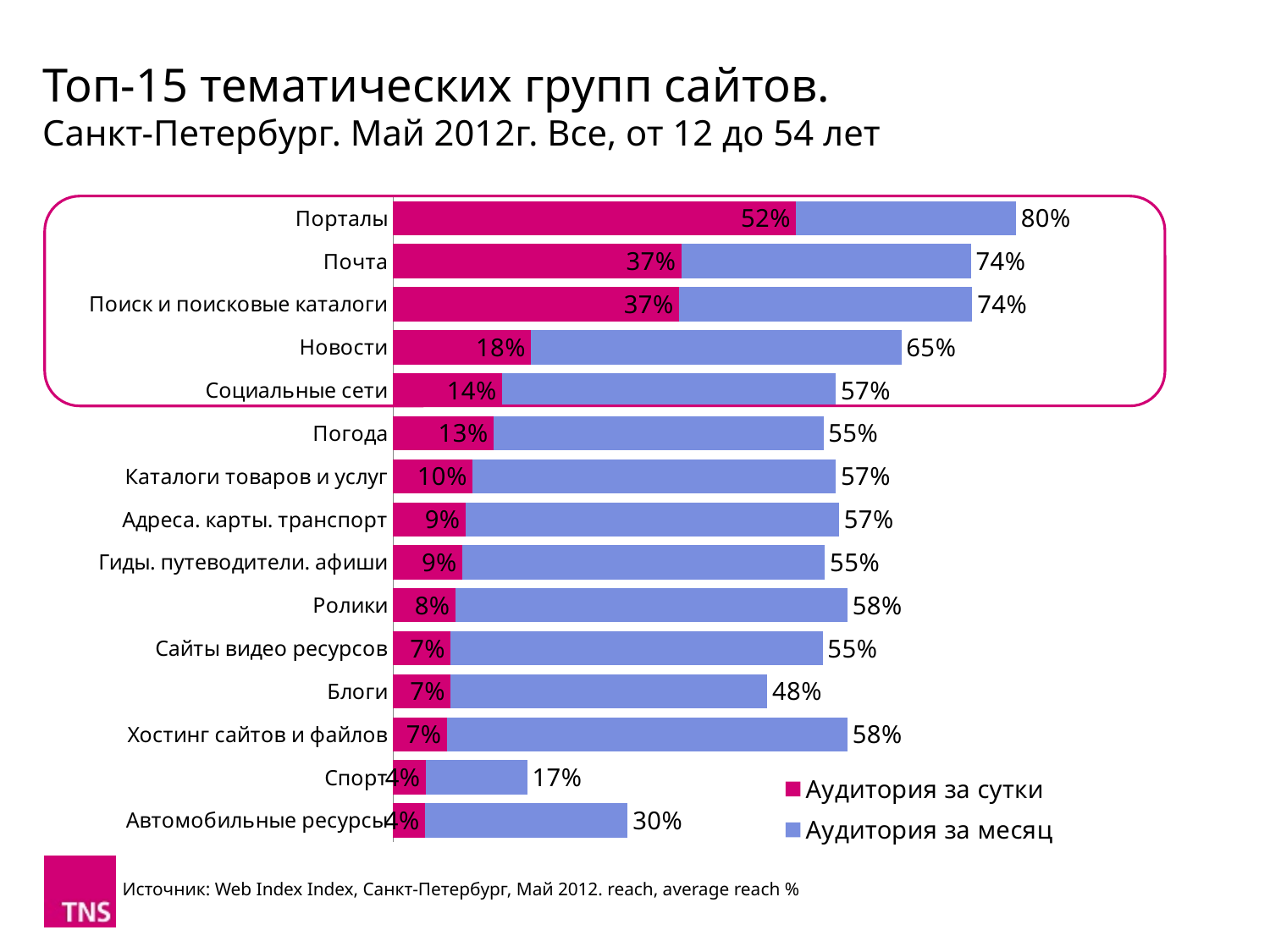
How many series does the legend list? 2 What is the monthly audience (Аудитория за месяц) value for Порталы? 80% What kind of chart is shown on the slide? bar chart How many thematic groups of sites are shown in the chart? 15 What is the difference between the monthly and daily audience values for Социальные сети? 43% Which category has the lowest monthly audience (Аудитория за месяц)? Спорт Which category has the highest monthly audience (Аудитория за месяц)? Порталы What is the daily audience (Аудитория за сутки) value for Новости? 18% Which series is shown in magenta in the legend? Аудитория за сутки What is the monthly audience (Аудитория за месяц) value for Блоги? 48% Which has a larger monthly audience (Аудитория за месяц): Погода or Ролики? Ролики What is the daily audience (Аудитория за сутки) value for Почта? 37%